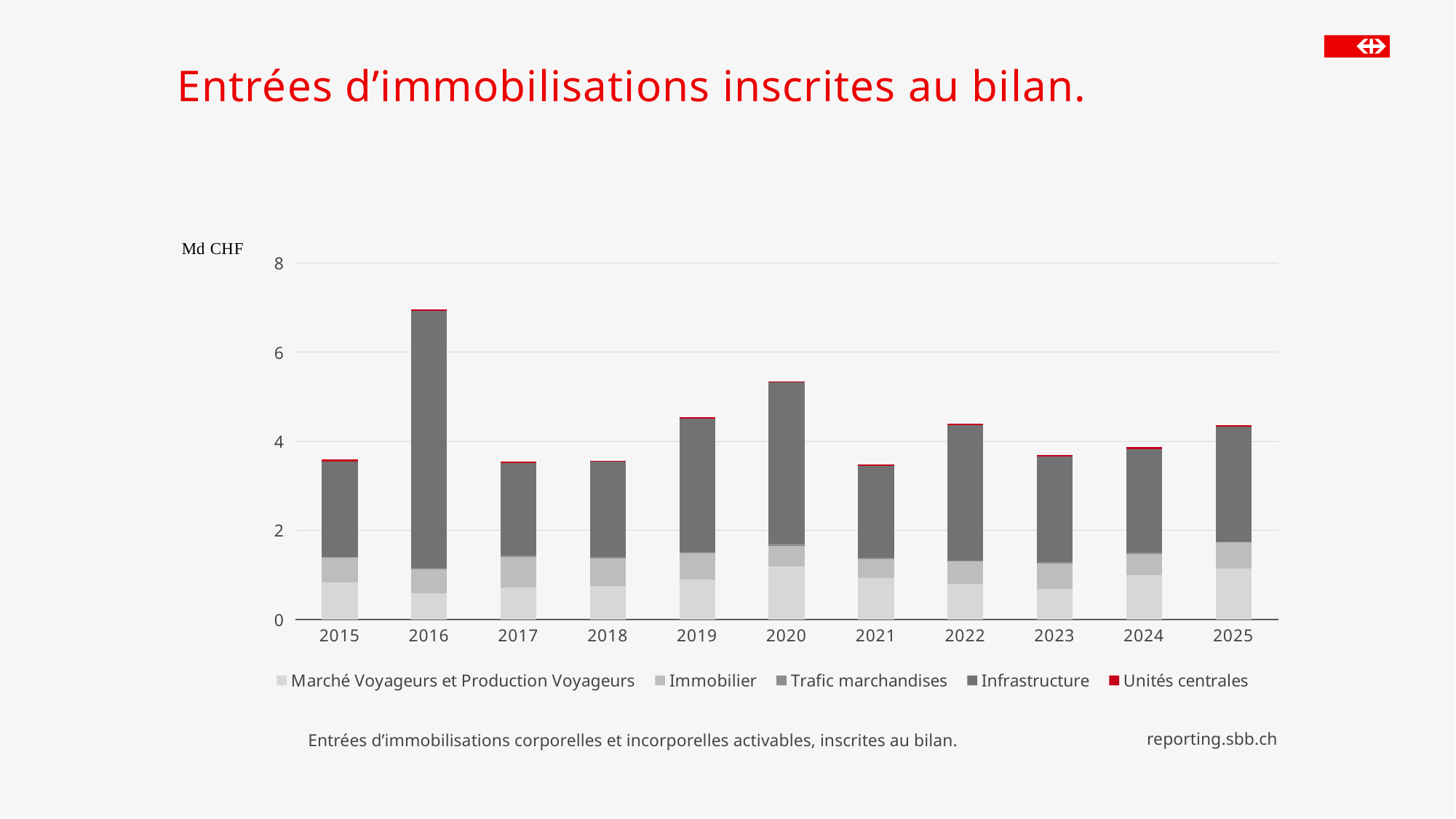
Is the total value for 2021 greater or less than 4? less Is the total value for 2018 greater or less than 4? less How many series does the chart's legend list? 5 Which year has the larger total bar, 2019 or 2023? 2019 Which year has the larger total bar, 2016 or 2020? 2016 What kind of chart is shown on the slide? stacked bar chart How many years are shown on the x axis of the chart? 11 What is the title of the chart on the slide? Entrées d’immobilisations inscrites au bilan. Which year has the highest total bar in the chart? 2016 Is the total value for 2016 greater or less than 6? greater What unit is shown on the y axis of the chart? Md CHF